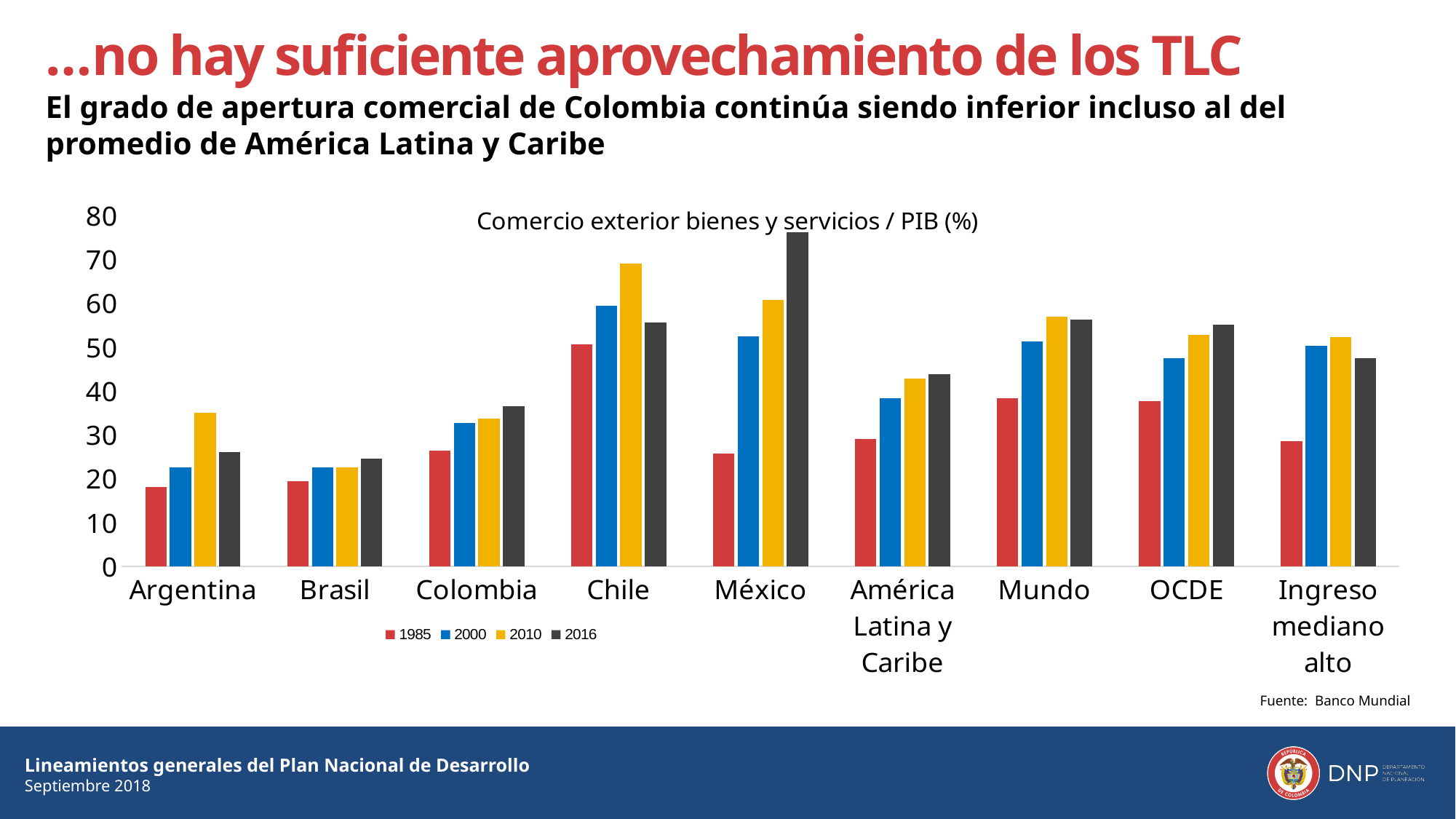
Which category has the highest value for 2016? México What kind of chart is shown on the slide? bar chart Is the value for Chile in 2010 greater or less than 60? greater Is the value for Colombia in 2016 greater or less than 40? less How many series does the legend list? 4 How many categories are shown on the x axis? 9 Which is larger in 2016: the value for Colombia or the value for América Latina y Caribe? América Latina y Caribe Do the values for Colombia rise or fall from 1985 to 2016? rise What is the title of the chart? Comercio exterior bienes y servicios / PIB (%) Which category has the highest value for 2010? Chile Is the value for México in 2016 greater or less than 70? greater Which category has the lowest value for 2016? Brasil